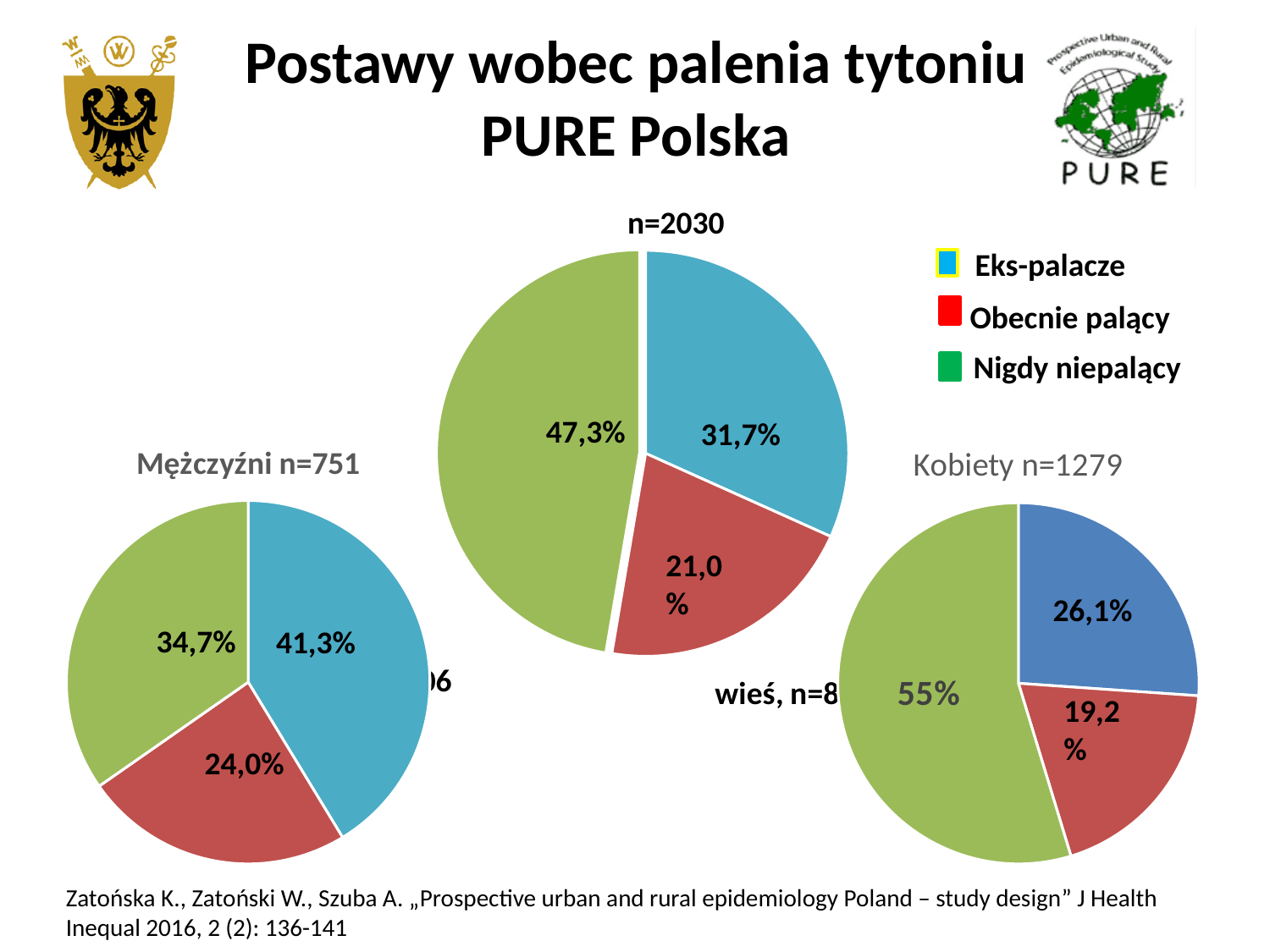
In the pie chart titled "Mężczyźni n=751", what percentage is shown for the Obecnie palący slice? 24,0% In the pie chart titled "Kobiety n=1279", which category has the smallest slice? Obecnie palący In the pie chart titled "Kobiety n=1279", what percentage is shown for the Nigdy niepalący slice? 55% Which is larger: the Eks-palacze share in the "Mężczyźni n=751" chart or the Eks-palacze share in the "Kobiety n=1279" chart? Mężczyźni n=751 How many entries does the legend on the slide list? 3 In the pie chart titled "Kobiety n=1279", what percentage is shown for the Obecnie palący slice? 19,2% What type of chart is used for the "n=2030" data? Pie chart In the pie chart titled "Mężczyźni n=751", which category has the largest slice? Eks-palacze In the pie chart titled "n=2030", what percentage is shown for the Eks-palacze slice? 31,7% How many slices does the pie chart titled "Kobiety n=1279" have? 3 In the pie chart titled "n=2030", what is the difference in percentage points between the Nigdy niepalący slice and the Obecnie palący slice? 26,3 In the pie chart titled "n=2030", what percentage is shown for the Nigdy niepalący slice? 47,3%